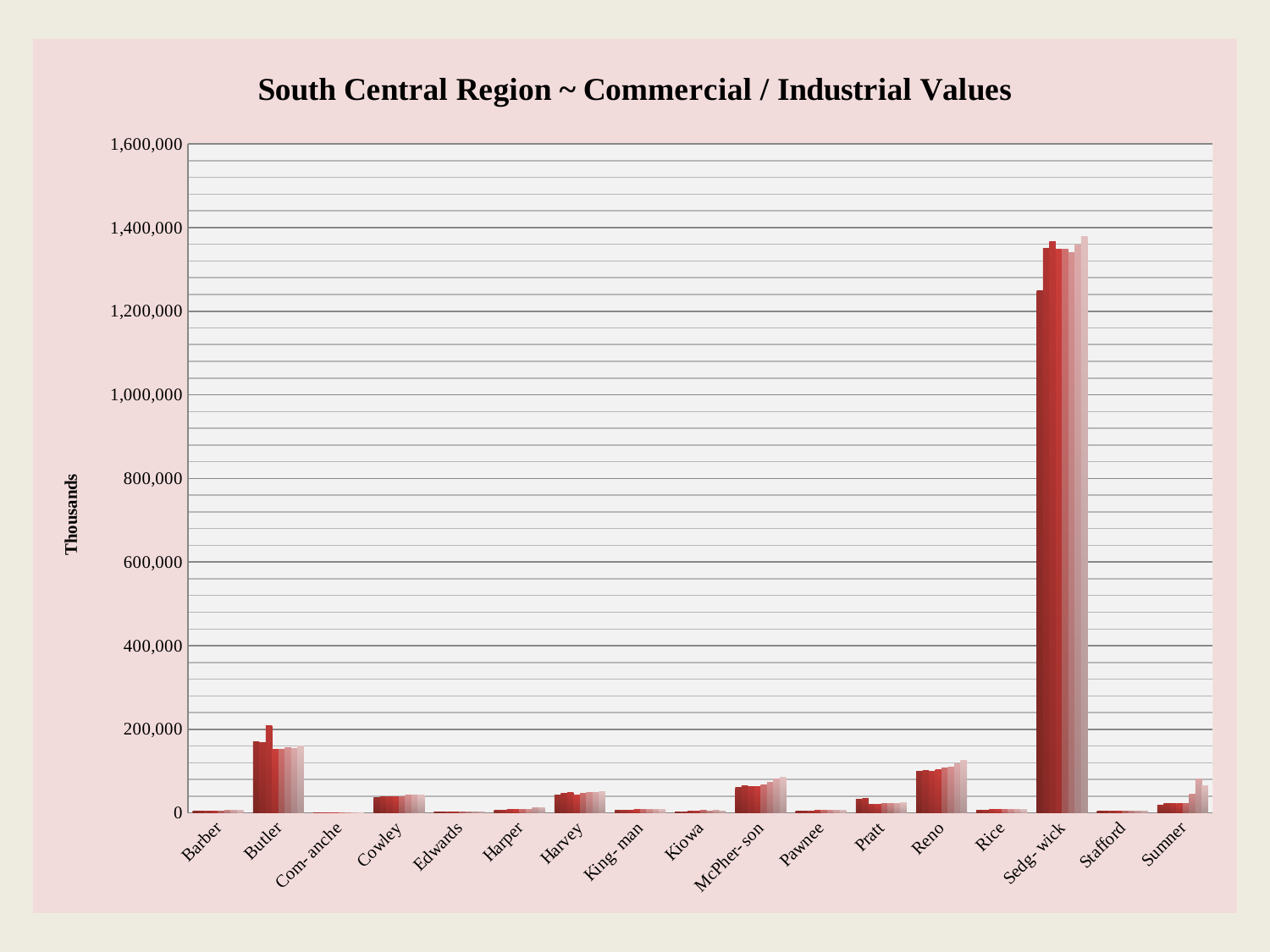
Which county has larger values, Sedgwick or Butler? Sedgwick Are the values for Reno greater or less than 200,000? less How many counties (categories) are shown on the x axis? 17 Which county has larger values, Butler or Reno? Butler What kind of chart is shown on the slide? bar chart Which county has larger values, Cowley or Comanche? Cowley What is the label on the vertical axis? Thousands Are the values for Sedgwick greater or less than 1,200,000? greater What is the title of the chart? South Central Region ~ Commercial / Industrial Values Which county has the highest commercial / industrial values? Sedgwick Are the values for Sedgwick greater or less than 1,400,000? less